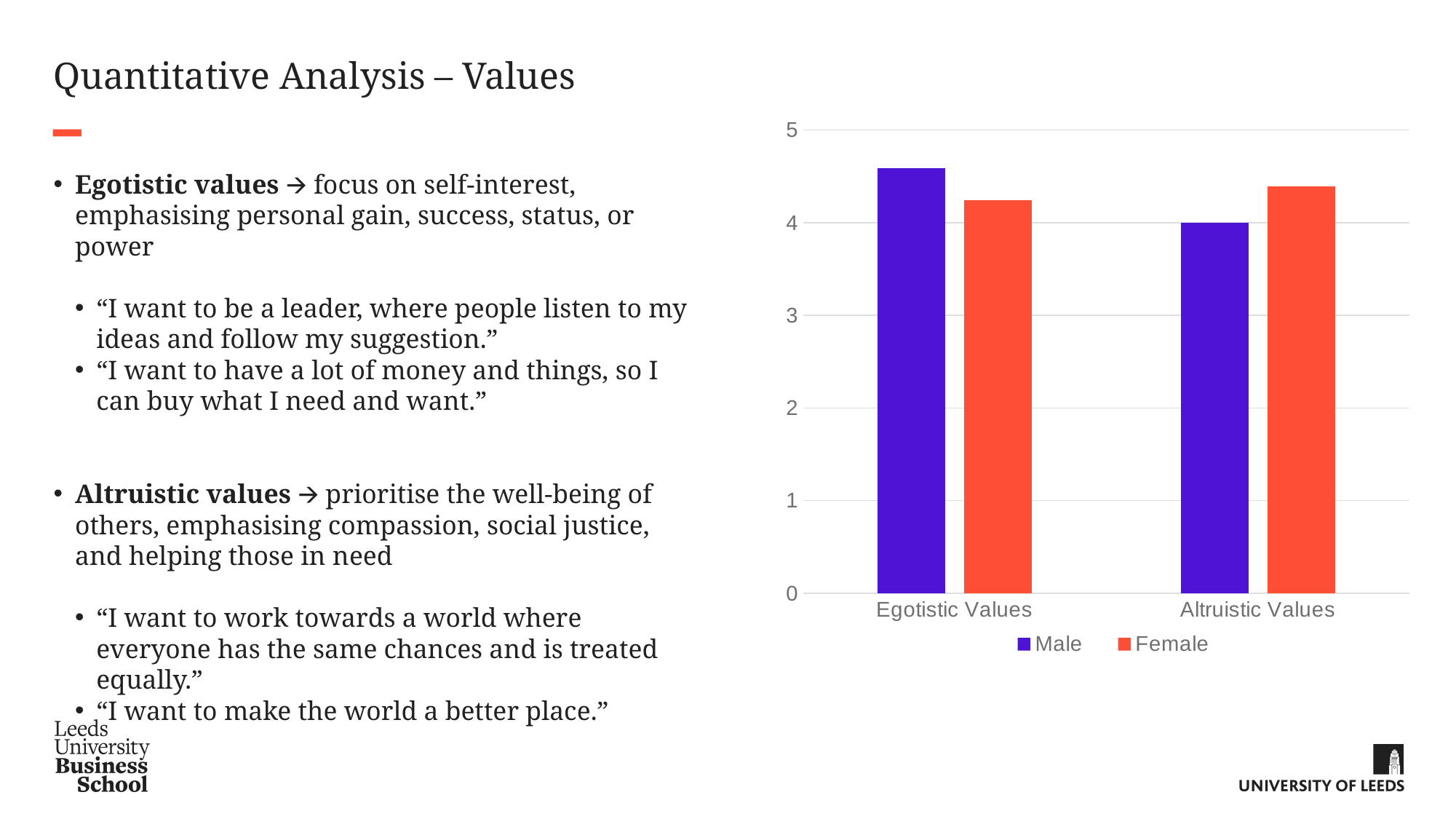
How many series does the chart legend list? 2 Which bar is the shortest in the chart? Male, Altruistic Values How many categories are shown on the x axis of the chart? 2 For the Male series, which category has the higher value? Egotistic Values For Egotistic Values, which is larger, the Male bar or the Female bar? Male Which series is shown in orange-red in the chart? Female For Altruistic Values, which is larger, the Male bar or the Female bar? Female Is the Male value for Egotistic Values greater or less than 4? greater Which bar is the tallest in the chart? Male, Egotistic Values What kind of chart is shown on the slide? bar chart Is the Female value for Altruistic Values greater or less than 5? less Which series is shown in purple in the chart? Male